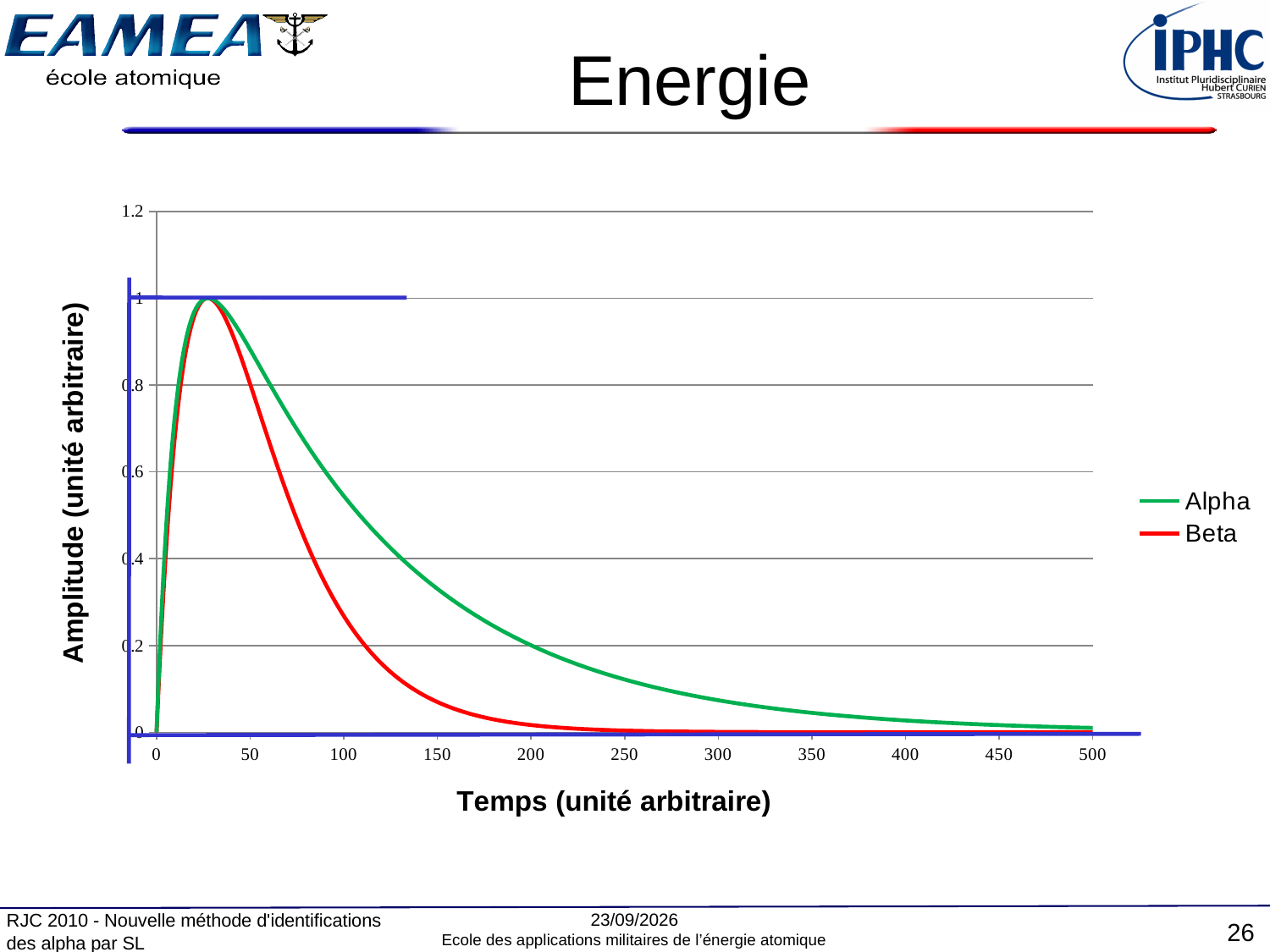
Is the amplitude of Alpha at Temps = 100 greater or less than 0.4? greater What are the names of the two series in the legend? Alpha and Beta Is the amplitude of Beta at Temps = 150 greater or less than 0.2? less What is the title of the x axis? Temps (unité arbitraire) At Temps = 100, which series has the higher amplitude, Alpha or Beta? Alpha What kind of chart is shown on the slide? line chart How many series does the legend list? 2 At Temps = 200, which series has the higher amplitude, Alpha or Beta? Alpha Is the amplitude of Alpha at Temps = 300 greater or less than 0.2? less What is the highest value shown on the y axis? 1.2 After reaching their peak, do the Alpha and Beta amplitudes rise or fall as Temps increases? fall